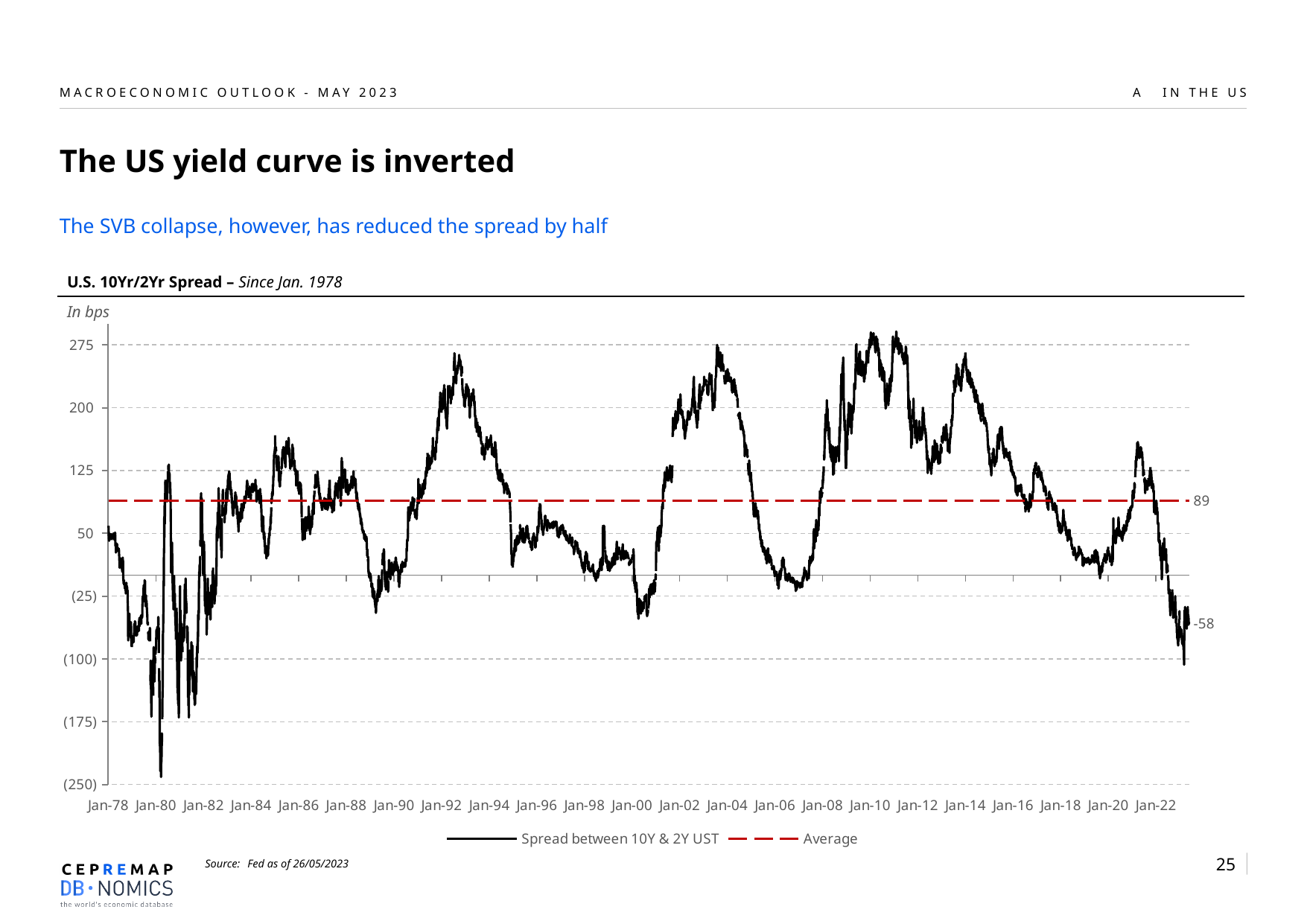
Does the spread rise or fall between Jan-22 and the end of the series? fall Is the peak of the spread around Jan-10 greater or less than 200? greater Is the lowest value of the spread around Jan-80 greater or less than (175)? less What is the value of the Average line labelled at the right of the chart? 89 Which is larger, the Average (89) or the latest spread value (-58)? Average What is the latest value of the spread between 10Y & 2Y UST labelled at the end of the line? -58 In what unit are the values on the chart expressed? bps Which legend entry is drawn as a red dashed line? Average What kind of chart is shown on the slide? line chart What is the difference between the Average (89) and the latest spread value (-58)? 147 How many year labels are shown on the x axis? 23 How many series does the legend list? 2